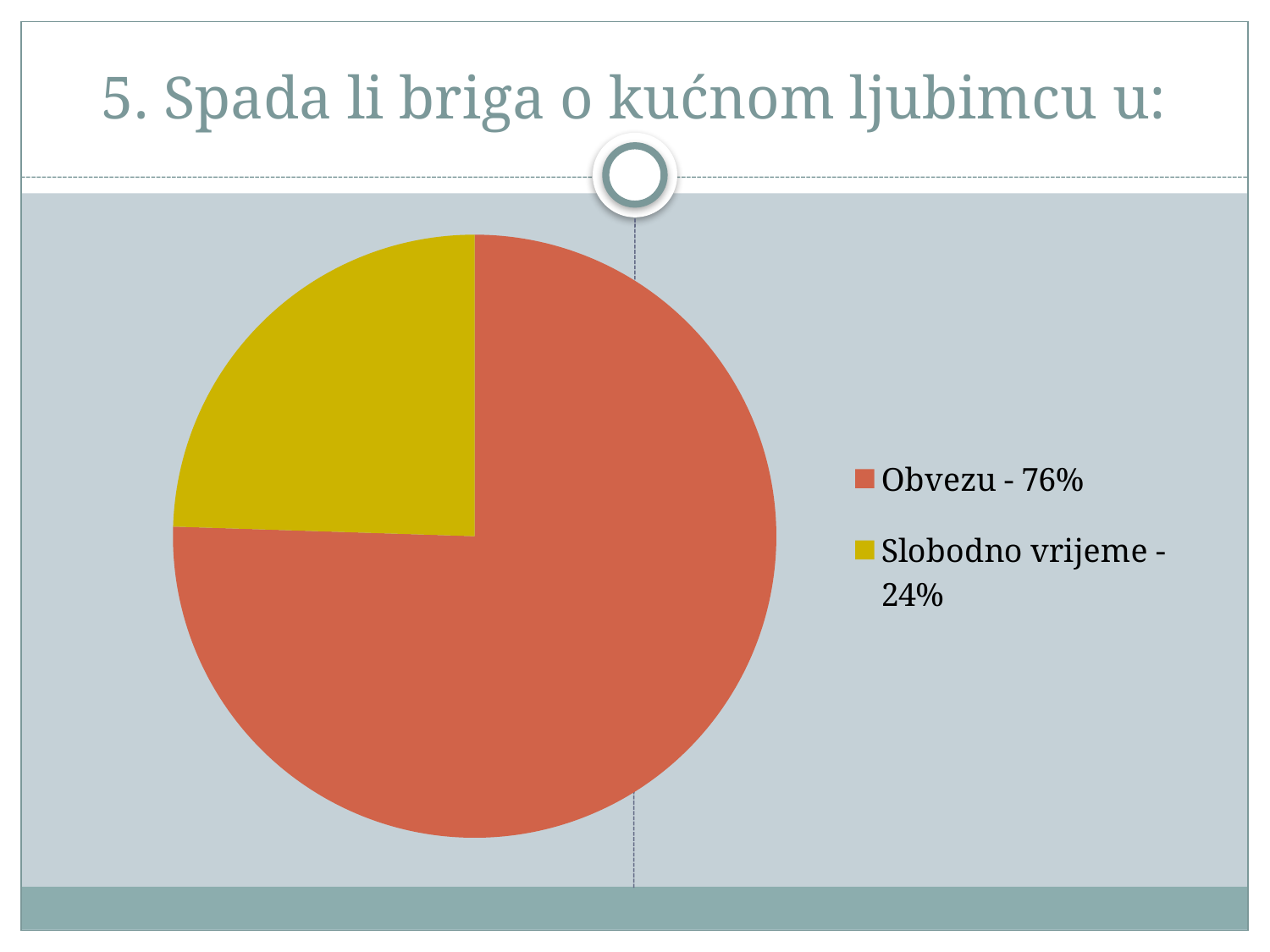
How many slices does the pie chart have? 2 Which category has the largest slice of the pie? Obvezu What share of the pie does "Slobodno vrijeme" represent? 24% Which is larger, the share for "Obvezu" or the share for "Slobodno vrijeme"? Obvezu What is the difference in percentage points between "Obvezu" and "Slobodno vrijeme"? 52 How many entries does the legend list? 2 What colour is the slice for "Obvezu"? red What colour is the slice for "Slobodno vrijeme"? yellow Which category has the smallest slice of the pie? Slobodno vrijeme What share of the pie does "Obvezu" represent? 76% What kind of chart is shown on the slide? pie chart